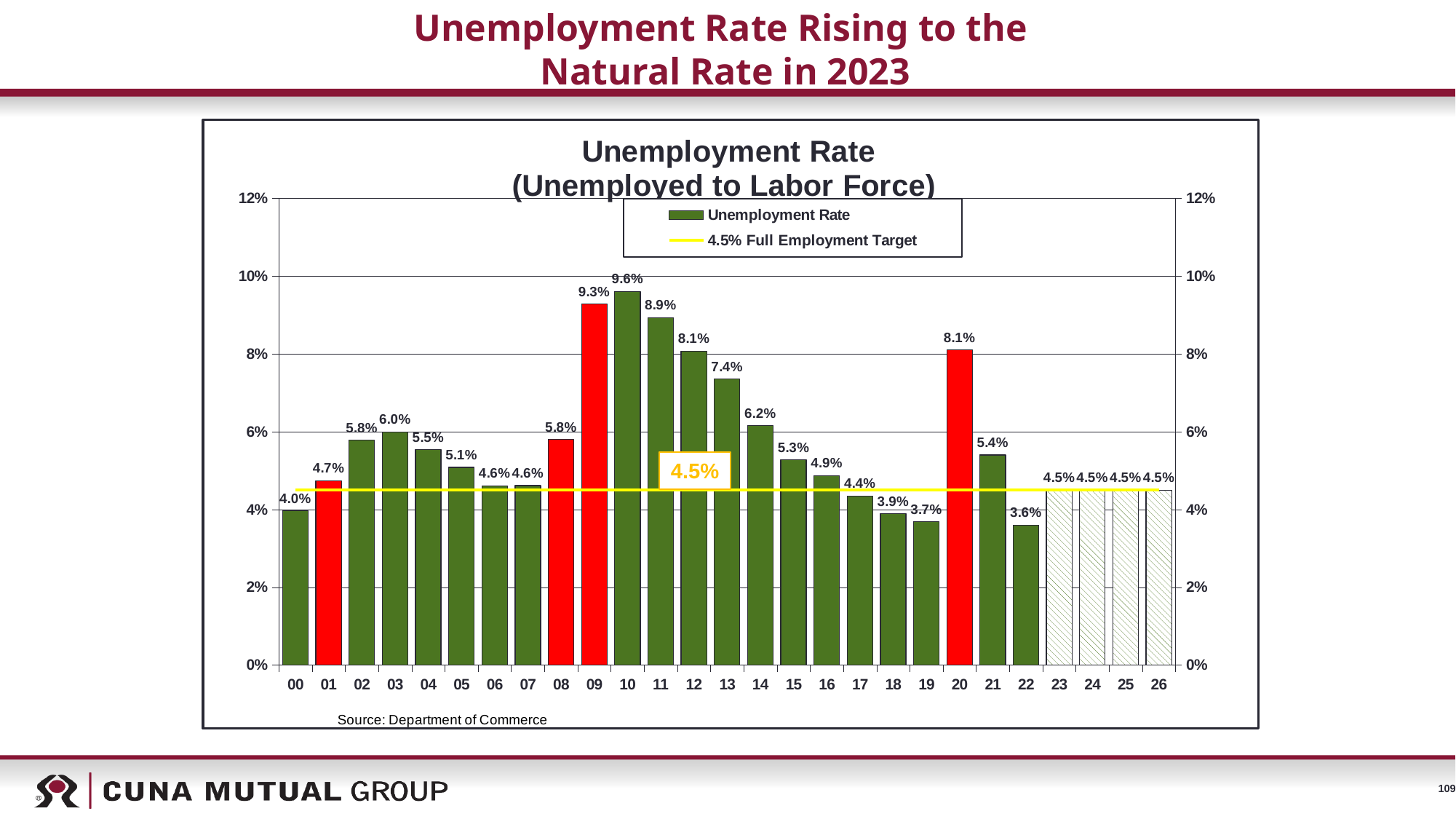
What is the unemployment rate shown for 2010? 9.6% Which year has a higher unemployment rate, 2011 or 2013? 2011 What is the unemployment rate shown for 2020? 8.1% How many entries does the chart legend list? 2 Is the unemployment rate for 2012 greater or less than 6%? greater What value is the full employment target line set at, according to the legend? 4.5% What is the unemployment rate shown for 2022? 3.6% Which year has the lowest unemployment rate on the chart? 22 How many years are shown on the x axis of the chart? 27 What is the difference between the unemployment rate in 2009 and in 2008? 3.5% Which year has the highest unemployment rate on the chart? 10 What kind of chart is used to show the unemployment rate? Bar chart